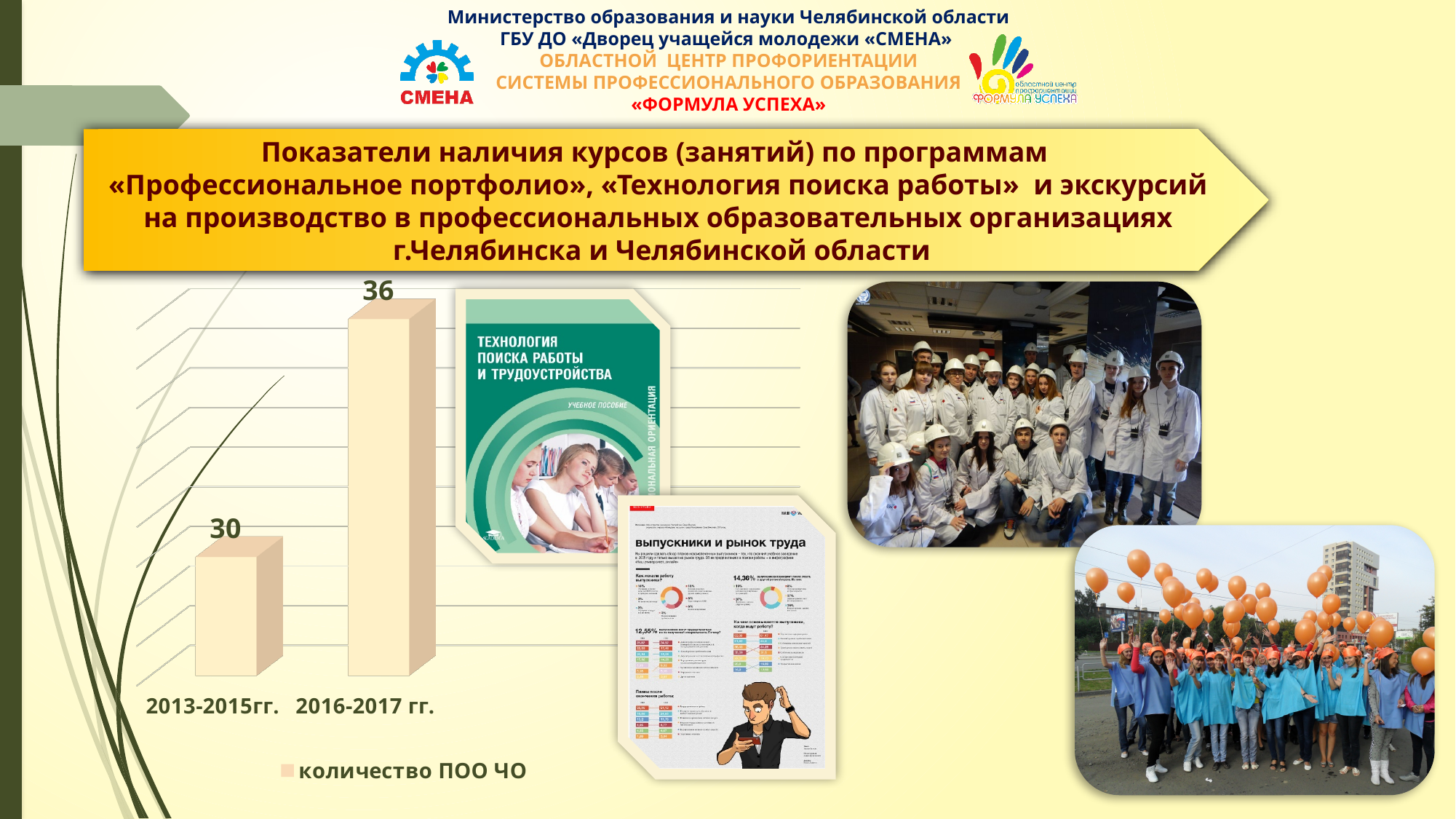
What is the name of the series listed in the chart legend? количество ПОО ЧО How many categories are shown on the x axis of the chart? 2 What is the value for 2016-2017 гг.? 36 What is the difference between the values for 2016-2017 гг. and 2013-2015гг.? 6 Which category has the lowest value? 2013-2015гг. Do the values rise or fall from 2013-2015гг. to 2016-2017 гг.? rise How many series does the legend list? 1 What is the value for 2013-2015гг.? 30 Which category has the highest value? 2016-2017 гг. Which is larger, the value for 2013-2015гг. or the value for 2016-2017 гг.? 2016-2017 гг. What kind of chart is shown on the slide? bar chart